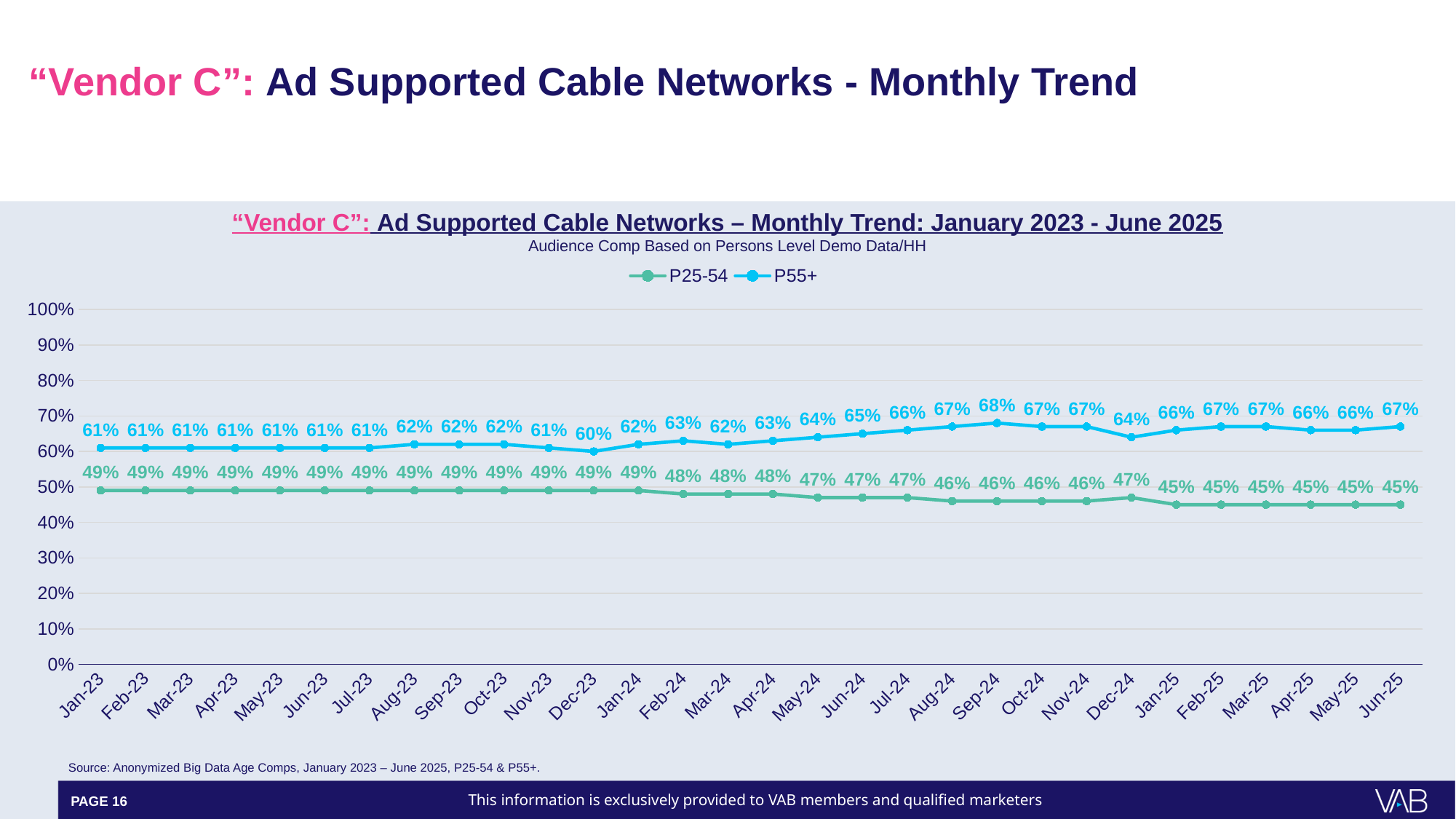
What is the difference between the P55+ and P25-54 values in Sep-24? 22 percentage points What is the P55+ value for Sep-24? 68% What is the P55+ value for Dec-23? 60% How many months are plotted on the x axis? 30 In Jan-23, which series has the larger value, P25-54 or P55+? P55+ How many series does the legend list? 2 Is the P25-54 value for Jan-25 greater or less than 60%? less In which month does the P55+ series reach its lowest value? Dec-23 What kind of chart is shown on the slide? line chart In which month does the P55+ series reach its highest value? Sep-24 Does the P25-54 series generally rise or fall from Jan-23 to Jun-25? fall What is the P25-54 value for Jun-25? 45%